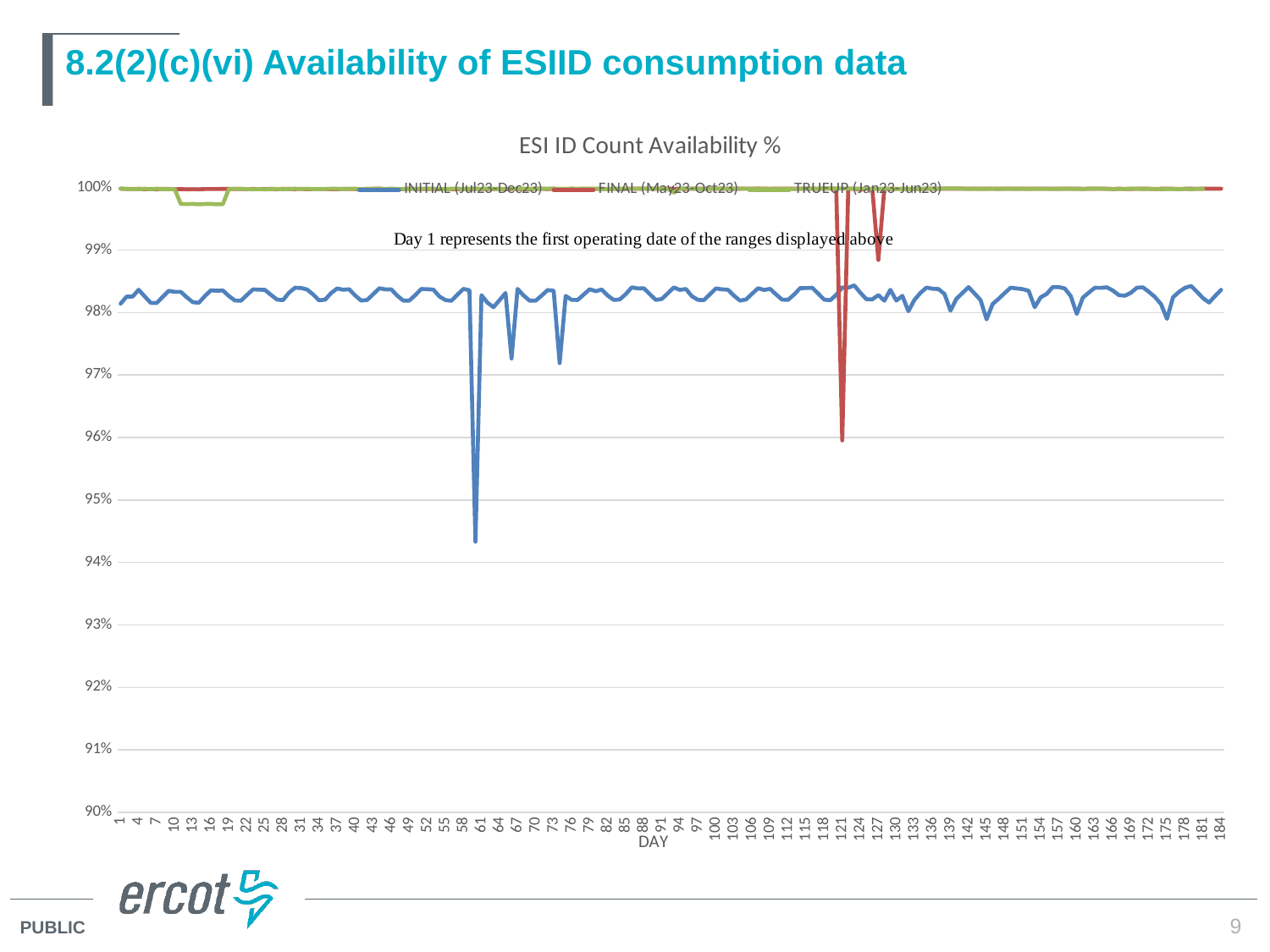
How many series does the legend list? 3 What is the title of the chart? ESI ID Count Availability % Is the value of the INITIAL (Jul23-Dec23) series at day 1 greater or less than 97%? greater What is the highest day number shown on the x axis? 184 Which series is generally higher across the chart, INITIAL (Jul23-Dec23) or TRUEUP (Jan23-Jun23)? TRUEUP (Jan23-Jun23) Is the lowest point of the FINAL (May23-Oct23) series, around day 121, greater or less than 97%? less Which series reaches the lowest value on the chart? INITIAL (Jul23-Dec23) What kind of chart is shown on the slide? line chart Is the lowest point of the INITIAL (Jul23-Dec23) series, around day 61, greater or less than 95%? less What colour is the FINAL (May23-Oct23) series line? red